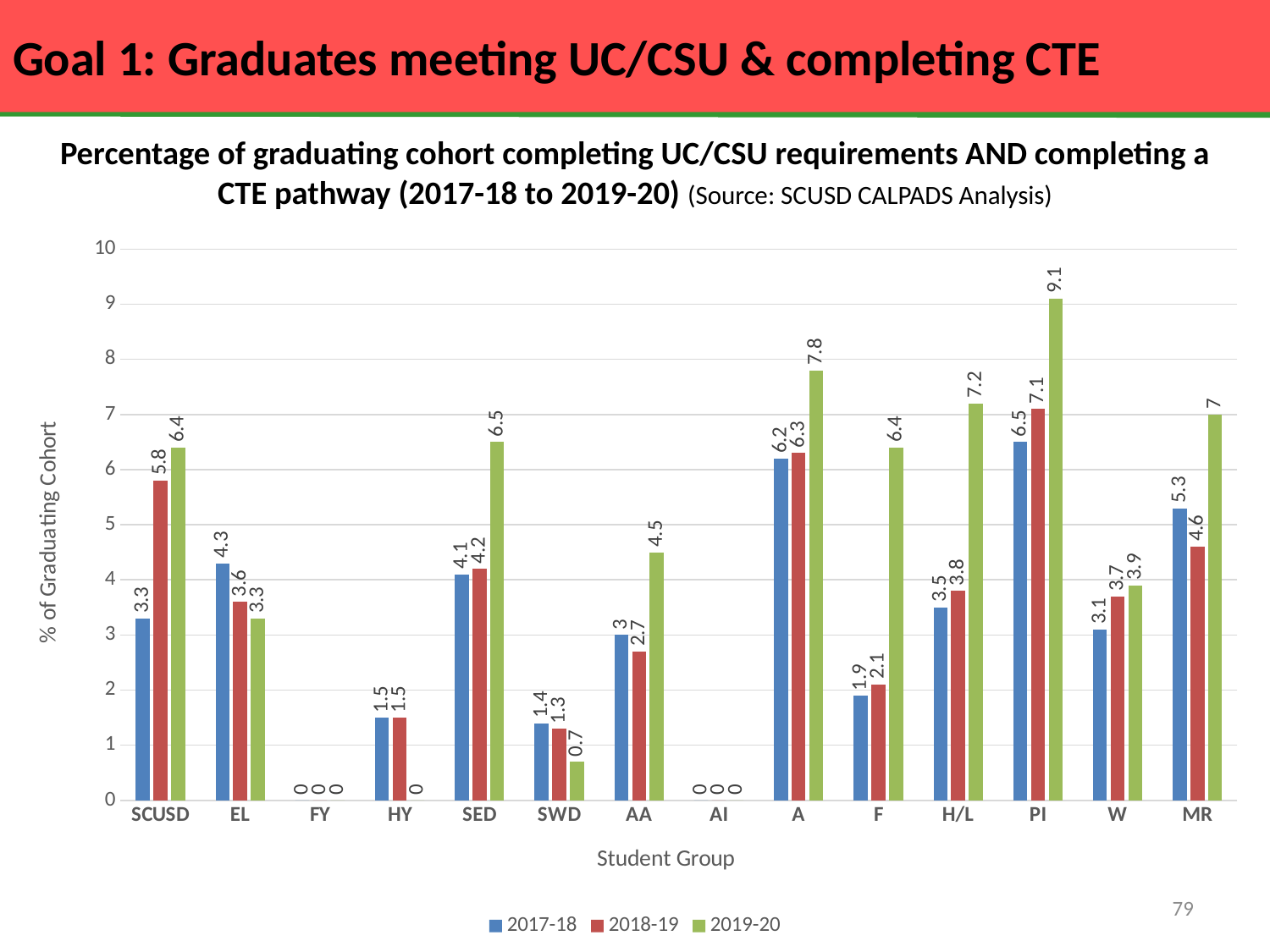
Do the values for F rise or fall from 2017-18 to 2019-20? rise How many series does the legend list? 3 Which student group has the highest 2019-20 value? PI What is the difference between the 2019-20 and 2017-18 values for SED? 2.4 Which student group has the lowest non-zero 2019-20 value? SWD What is the 2018-19 value for SWD? 1.3 What is the 2019-20 value for PI? 9.1 What is the 2017-18 value for SCUSD? 3.3 Which is larger for EL: the 2017-18 value or the 2019-20 value? 2017-18 How many student groups are shown on the x axis? 14 What kind of chart is shown? bar chart Is the 2019-20 value for A greater or less than 7? greater